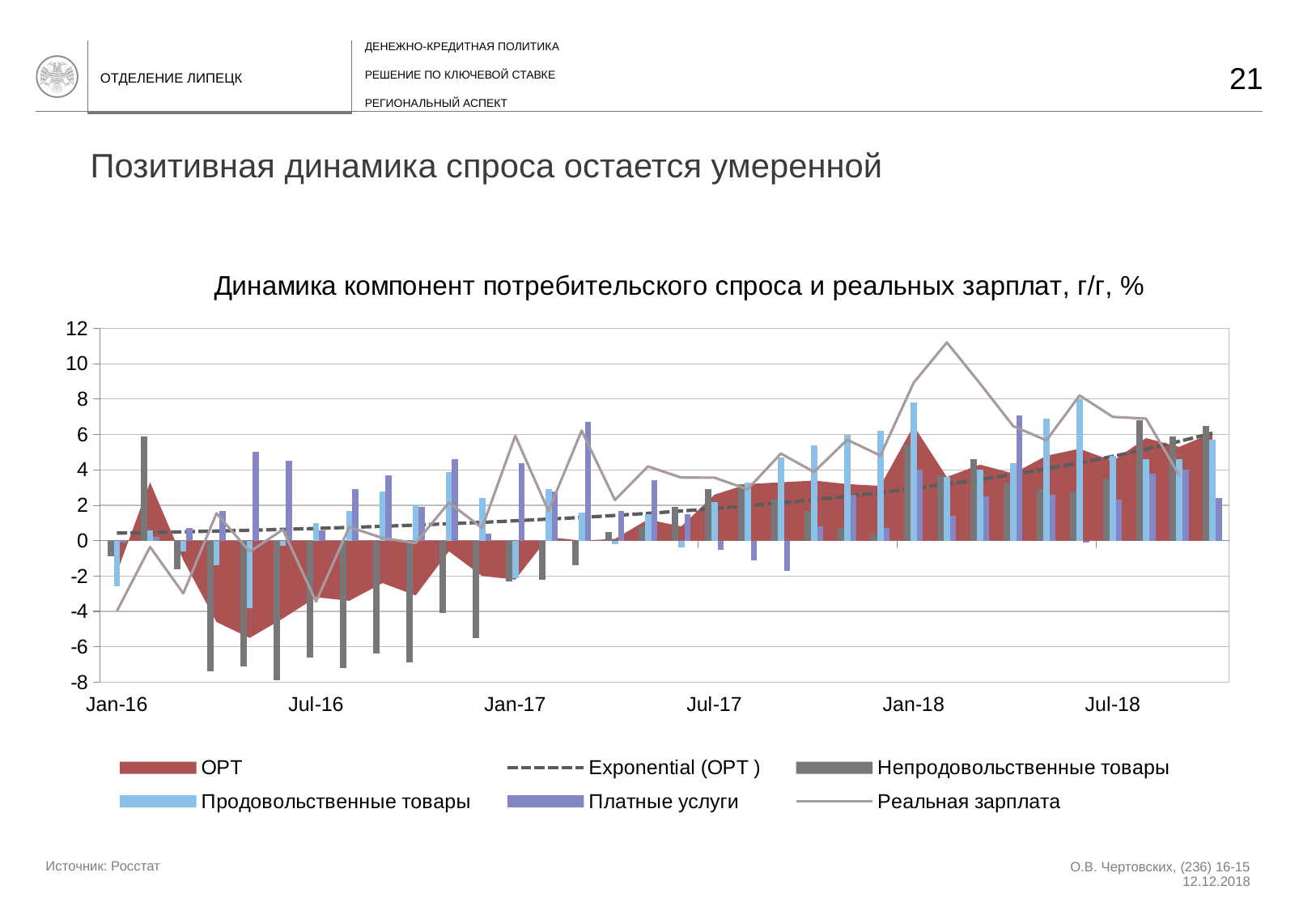
Is the highest Продовольственные товары bar greater or less than 6? greater What kind of chart is this? Combination chart (bars, area and lines) What colour is the ОРТ series shown in? Dark red Does the Реальная зарплата line overall rise or fall between Jan-16 and the end of the period? Rises At Jan-16, which is larger: Непродовольственные товары or Продовольственные товары? Непродовольственные товары Is the highest value of the Реальная зарплата line greater or less than 10? greater What is the title of the chart? Динамика компонент потребительского спроса и реальных зарплат, г/г, % Does the dashed Exponential (ОРТ) trend line rise or fall from Jan-16 to the end of the period? Rises How many series does the chart legend list? 6 Is the value of Реальная зарплата at Jan-16 greater or less than -2? less How many date labels are shown on the x axis? 6